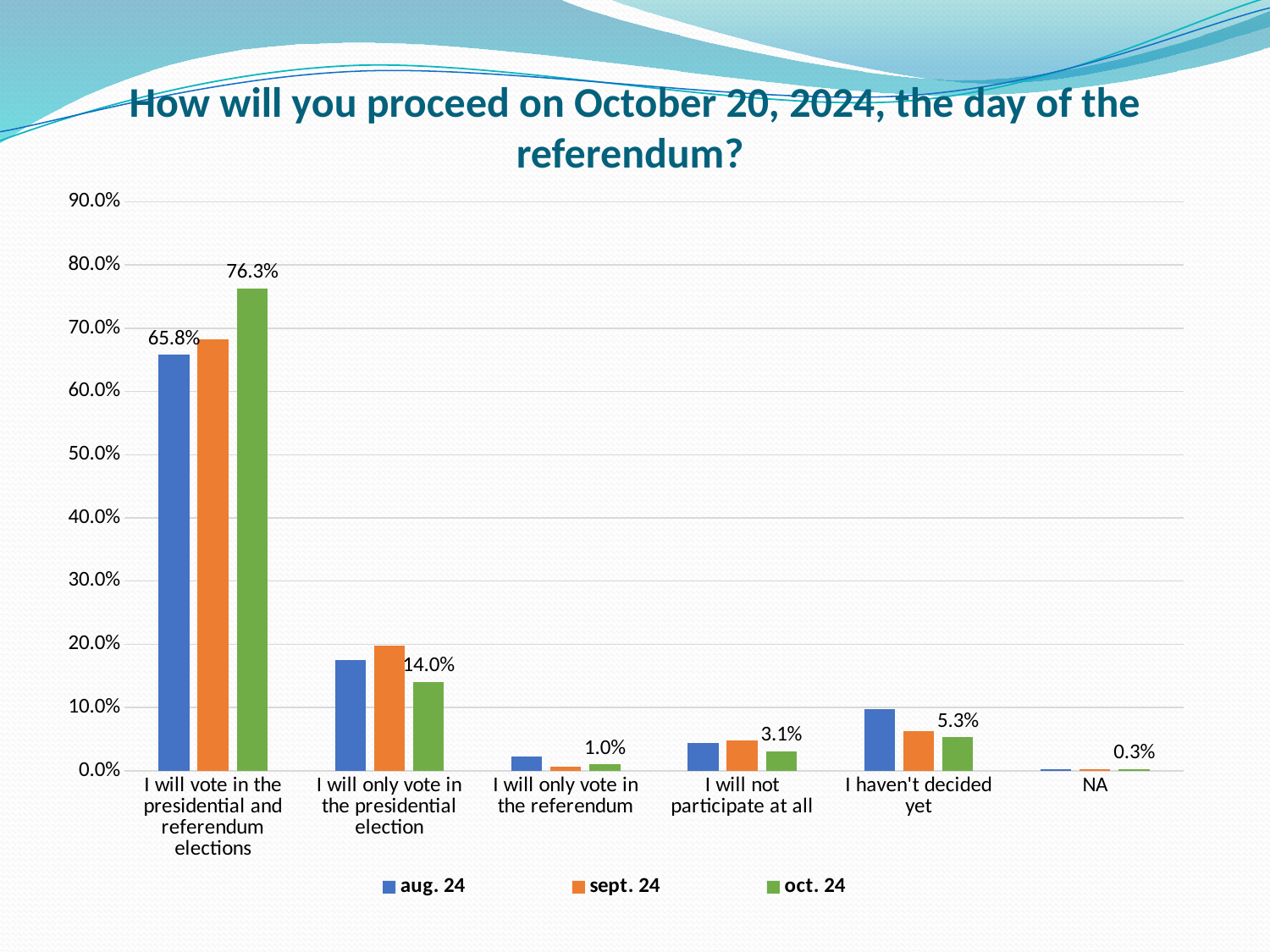
What kind of chart is shown on the slide? bar chart What is the aug. 24 value for 'I will vote in the presidential and referendum elections'? 65.8% How many series does the legend list? 3 Which category has the highest oct. 24 value? I will vote in the presidential and referendum elections How many response categories are shown on the x axis? 6 What is the oct. 24 value for 'I haven't decided yet'? 5.3% What is the oct. 24 value for 'NA'? 0.3% Is the sept. 24 value for 'I will only vote in the presidential election' greater or less than 10.0%? greater What is the difference between the oct. 24 and aug. 24 values for 'I will vote in the presidential and referendum elections'? 10.5% What is the oct. 24 value for 'I will only vote in the presidential election'? 14.0% What is the oct. 24 value for 'I will vote in the presidential and referendum elections'? 76.3% Which is larger for 'I will only vote in the presidential election': the sept. 24 value or the oct. 24 value? sept. 24